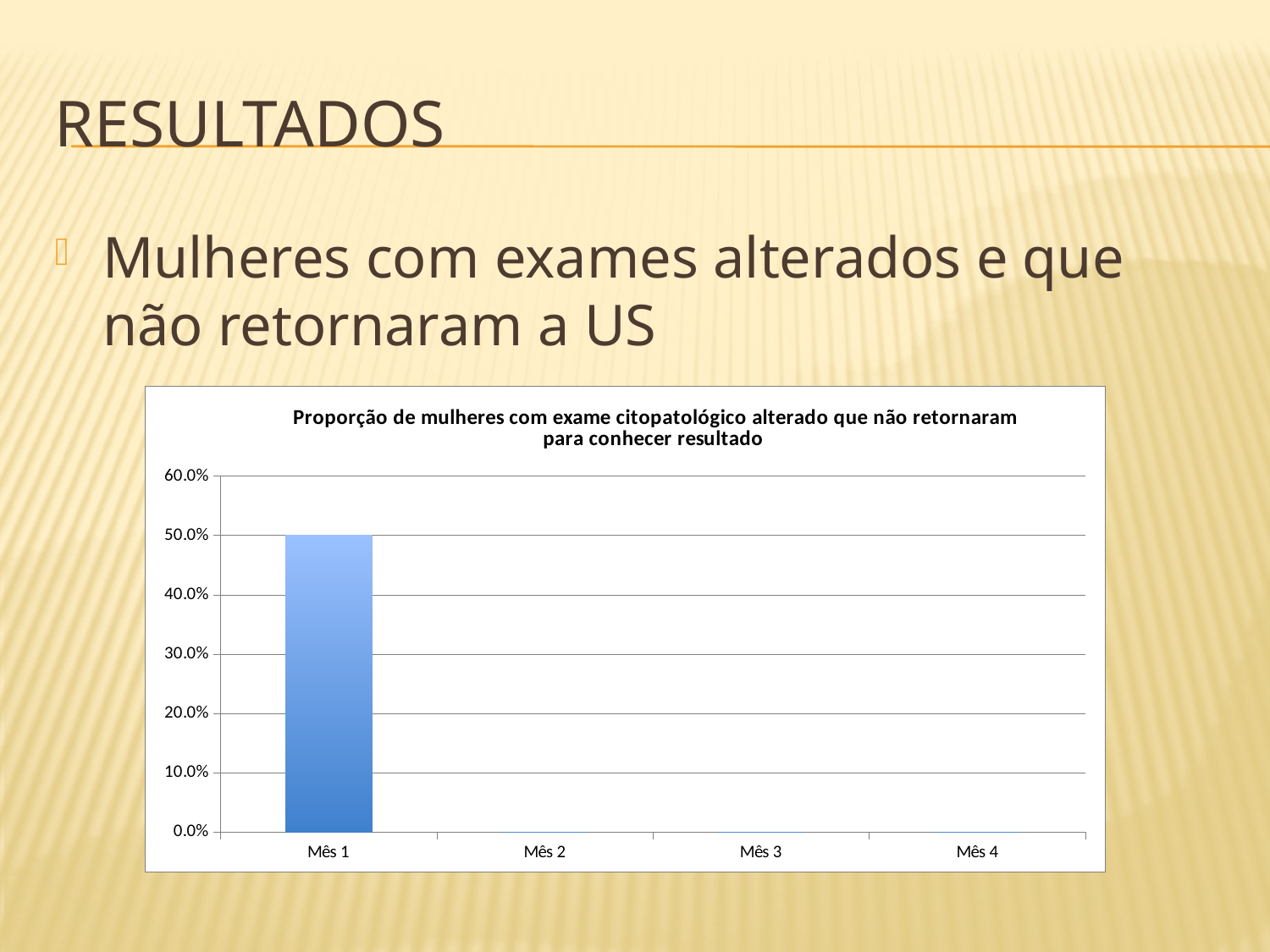
Which month has the highest value? Mês 1 Is the value for Mês 2 greater or less than 10.0%? less What is the highest value shown on the y axis? 60.0% Which is larger, the value for Mês 1 or the value for Mês 3? Mês 1 Is the value for Mês 1 greater or less than 40.0%? greater How many months are shown on the x axis? 4 Is the value for Mês 4 greater or less than 20.0%? less What is the title of the chart? Proporção de mulheres com exame citopatológico alterado que não retornaram para conhecer resultado What is the value for Mês 1? 50.0% What kind of chart is shown? bar chart